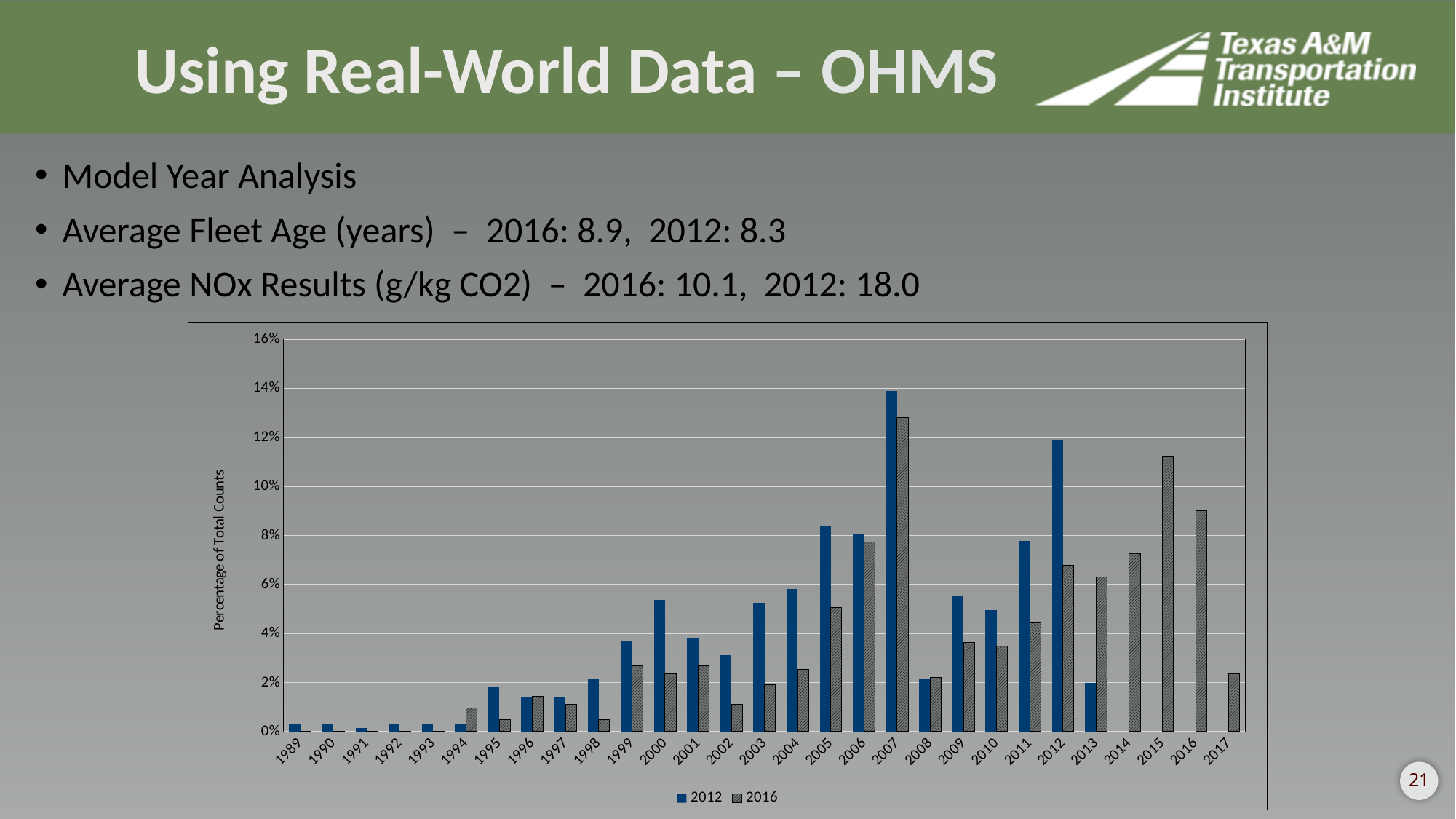
Does the 2016 series rise or fall from model year 2013 to model year 2015? rise What is the label on the y axis of the chart? Percentage of Total Counts Is the 2012 series value for model year 2007 greater or less than 12%? greater How many model years are shown on the x axis of the chart? 29 What type of chart is shown on the slide? bar chart Which model year has the highest value for the 2016 series? 2007 For model year 1994, which series has the larger value, 2012 or 2016? 2016 How many series does the chart legend list? 2 Is the 2016 series value for model year 2015 greater or less than 10%? greater Is the 2016 series value for model year 2002 greater or less than 2%? less For model year 2012, which series has the larger value, 2012 or 2016? 2012 Which model year has the highest value for the 2012 series? 2007